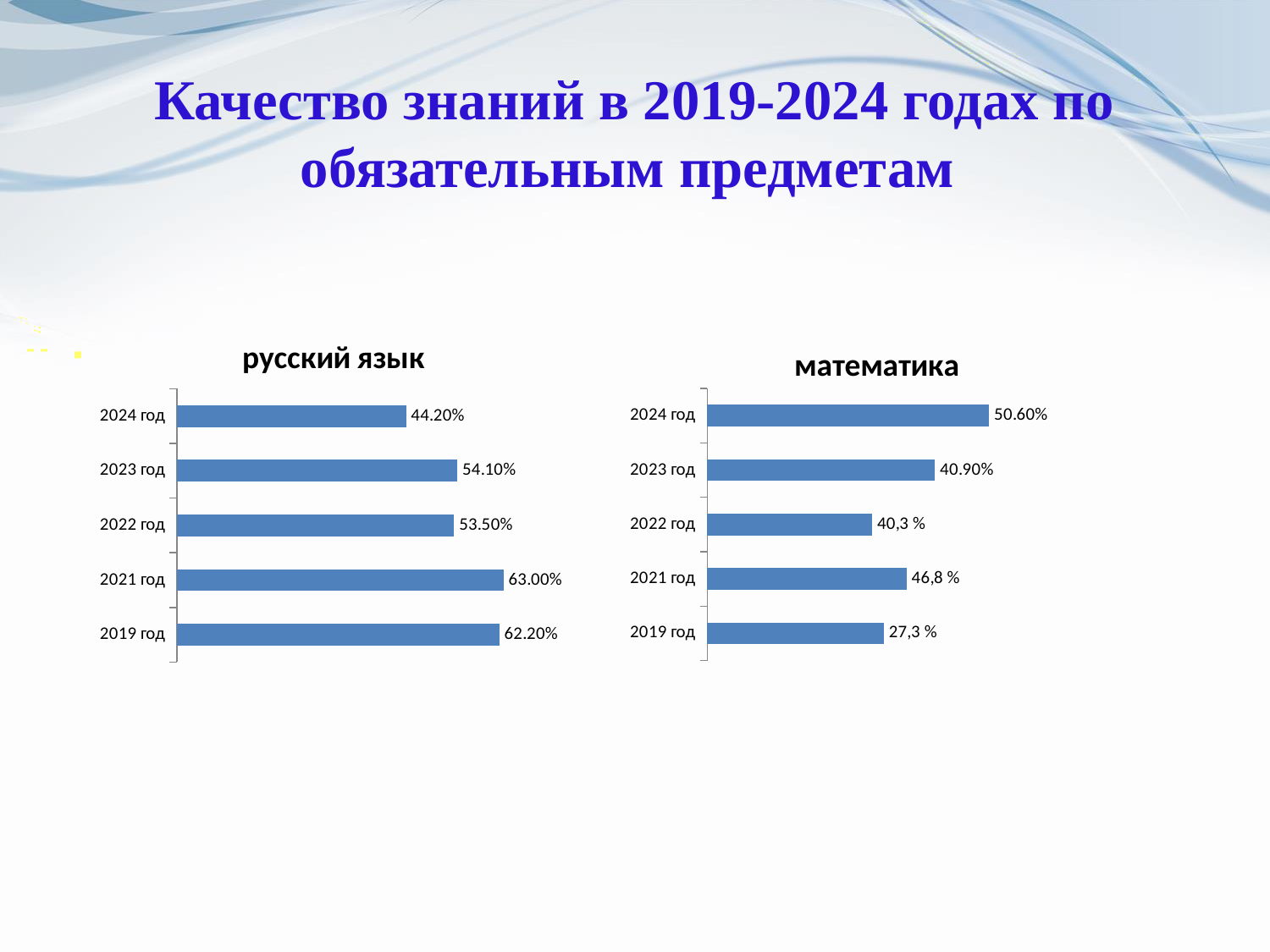
What is the title of the chart on the right side of the slide? математика What type of chart is the 'русский язык' chart? bar chart In the 'русский язык' chart, which year has the lowest value? 2024 год In the 'русский язык' chart, what is the value for 2023 год? 54.10% In the 'математика' chart, what is the value for 2021 год? 46,8 % In the 'математика' chart, what is the difference between the values for 2024 год and 2023 год? 9.70% In the 'русский язык' chart, which is larger: the value for 2022 год or the value for 2024 год? 2022 год In the 'русский язык' chart, which year has the highest value? 2021 год How many years are shown in the 'математика' chart? 5 In the 'математика' chart, which year has the highest value? 2024 год In the 'математика' chart, what is the value for 2019 год? 27,3 %